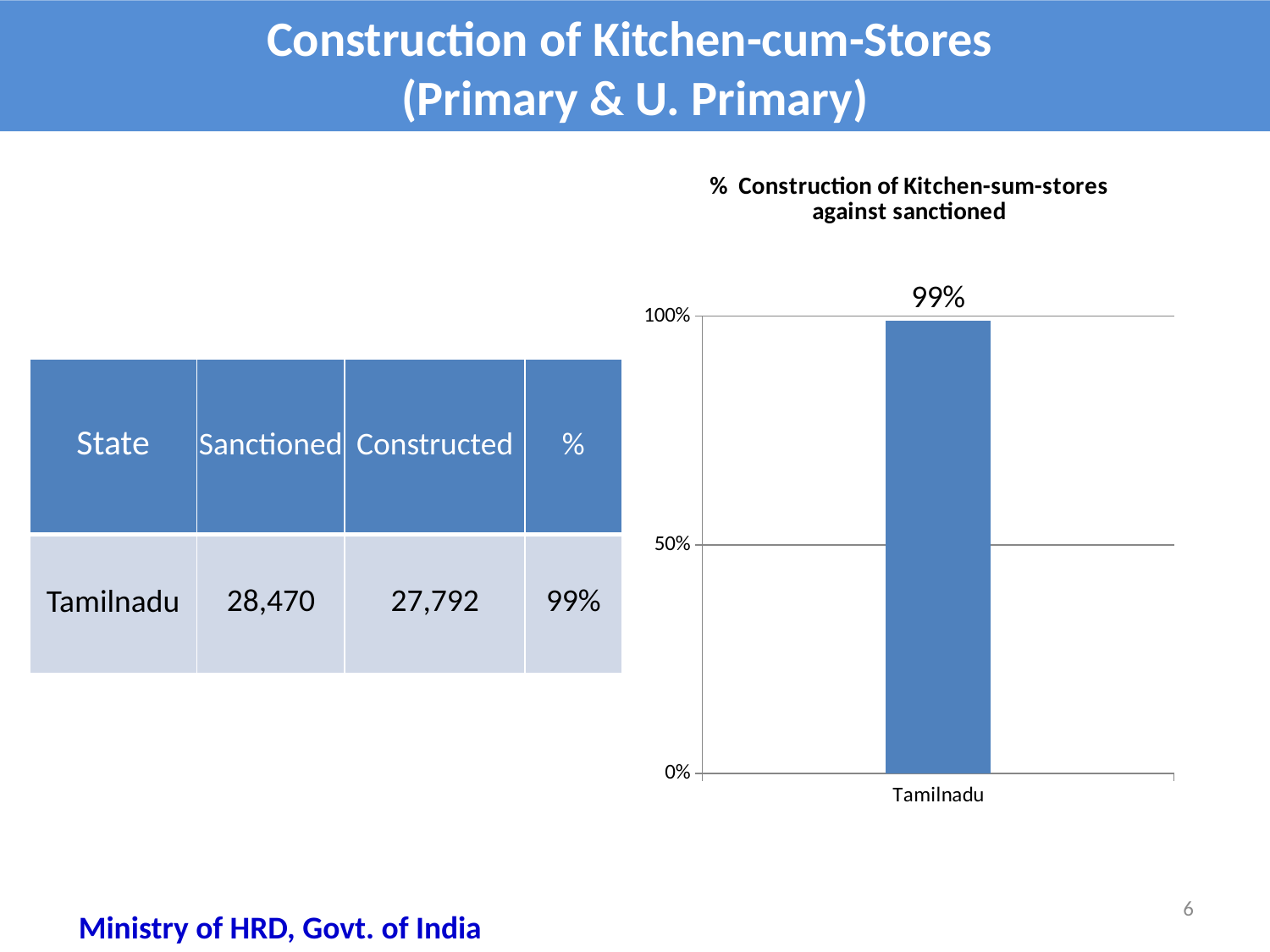
Which state is shown on the x axis of the chart? Tamilnadu What kind of chart is shown on the slide? bar chart What is the value shown for Tamilnadu in the chart? 99% What is the title of the chart? % Construction of Kitchen-sum-stores against sanctioned What is the highest value shown on the chart's y axis? 100% Is the value for Tamilnadu greater or less than 50%? greater How many categories are plotted in the chart? 1